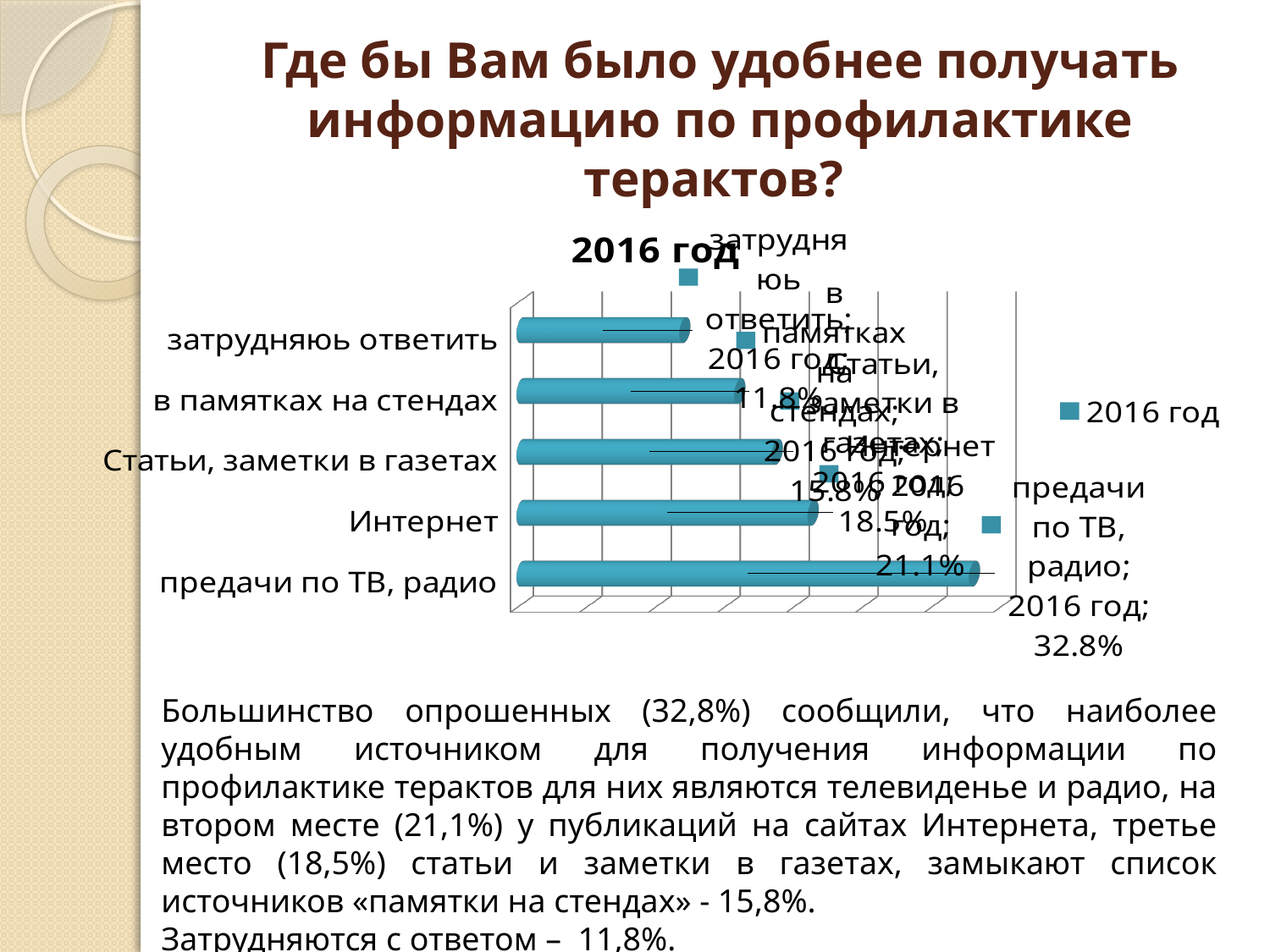
What is the value for "предачи по ТВ, радио"? 32.8% Which category has the lowest value? затрудняюь ответить What is the value for "Интернет"? 21.1% What is the value for "в памятках на стендах"? 15.8% What kind of chart is shown on the slide? bar chart What is the value for "Статьи, заметки в газетах"? 18.5% Which category has the highest value? предачи по ТВ, радио Which is larger, the value for "Интернет" or the value for "Статьи, заметки в газетах"? Интернет How many series does the legend list? 1 What is the difference between the values for "предачи по ТВ, радио" and "Интернет"? 11.7% What is the value for "затрудняюь ответить"? 11.8% How many categories are shown in the chart? 5